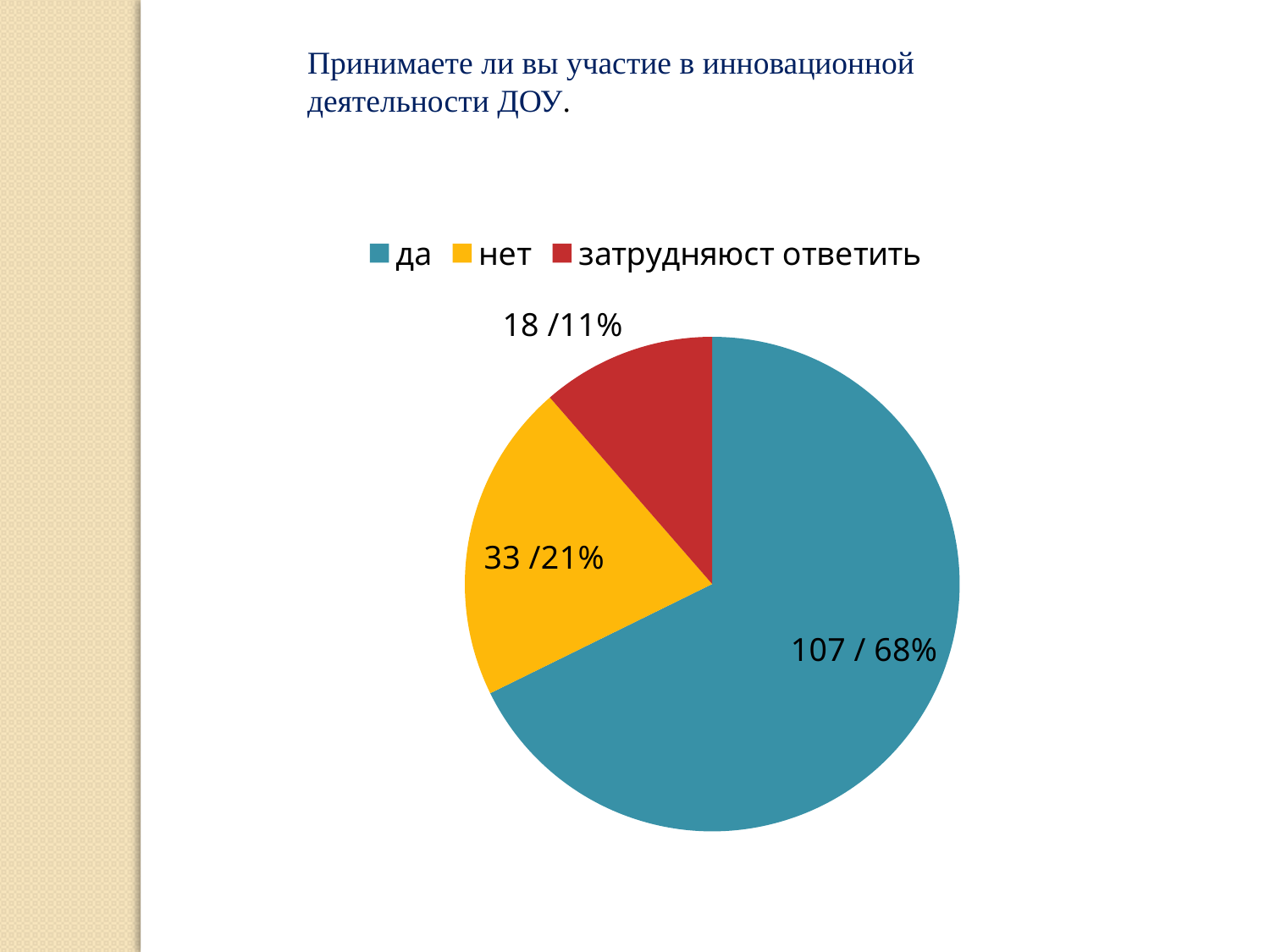
How many slices does the pie chart have? 3 What is the data label on the "да" slice? 107 / 68% Which category has the largest slice? да How many entries does the legend list? 3 What is the data label on the "затрудняюст ответить" slice? 18 /11% Which colour is used for the "нет" slice? yellow Which category has the smallest slice? затрудняюст ответить What is the data label on the "нет" slice? 33 /21% What percentage share of the pie does the "да" slice represent? 68% What kind of chart is shown on the slide? pie chart What is the difference between the counts for "да" and "нет"? 74 What percentage share of the pie does the "нет" slice represent? 21%